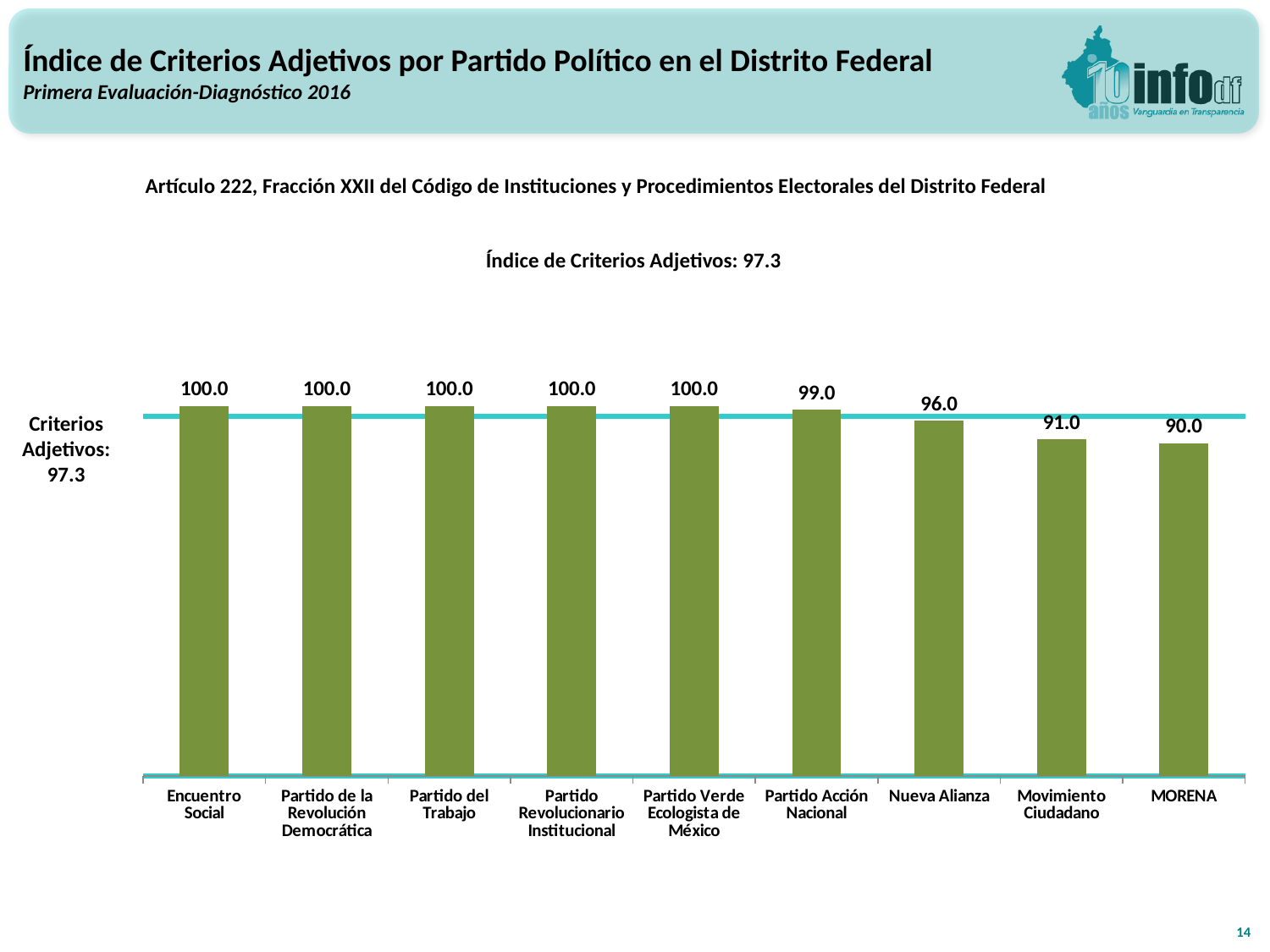
What is the value for Nueva Alianza? 96.0 What value does the horizontal reference line labelled 'Criterios Adjetivos' mark? 97.3 What kind of chart is shown? bar chart Which party has the lowest value? MORENA What is the value for Partido Acción Nacional? 99.0 What is the difference between the values for Nueva Alianza and Movimiento Ciudadano? 5.0 Do the values rise or fall from left to right across the chart? fall What is the difference between the values for Partido Acción Nacional and MORENA? 9.0 What is the value for MORENA? 90.0 Which is larger, the value for Nueva Alianza or the value for Movimiento Ciudadano? Nueva Alianza What is the value for Movimiento Ciudadano? 91.0 How many parties are shown in the chart? 9